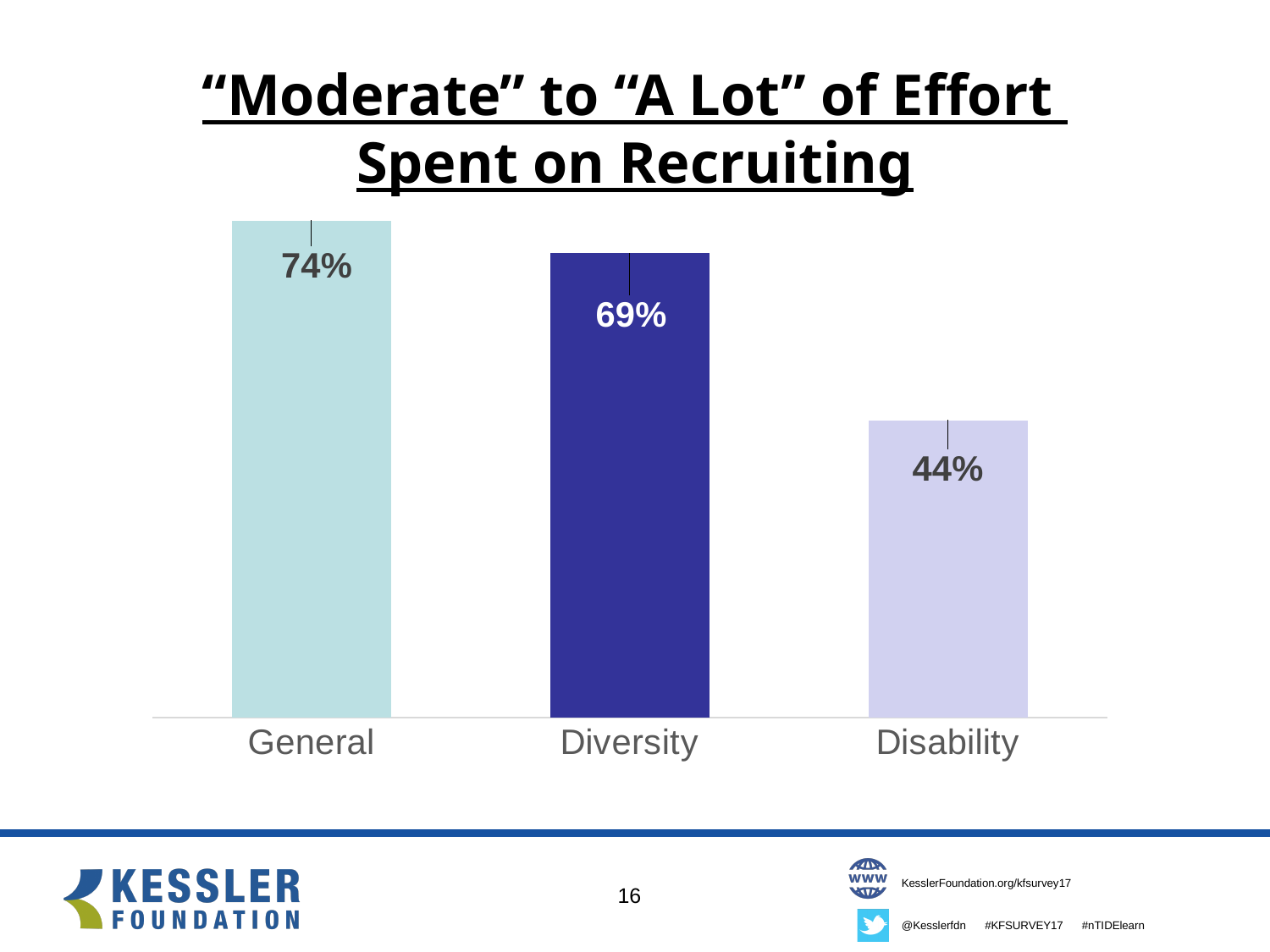
Do the values rise or fall from left to right across the categories? Fall Which is larger, the value for Diversity or the value for Disability? Diversity What is the difference between the values for General and Disability? 30% What kind of chart is shown on the slide? Bar chart What is the difference between the values for General and Diversity? 5% What is the value for Diversity? 69% Which category has the highest value? General How many categories are shown in the chart? 3 What is the value for Disability? 44% What is the value for General? 74% Which category has the lowest value? Disability What is the title of the chart? "Moderate" to "A Lot" of Effort Spent on Recruiting